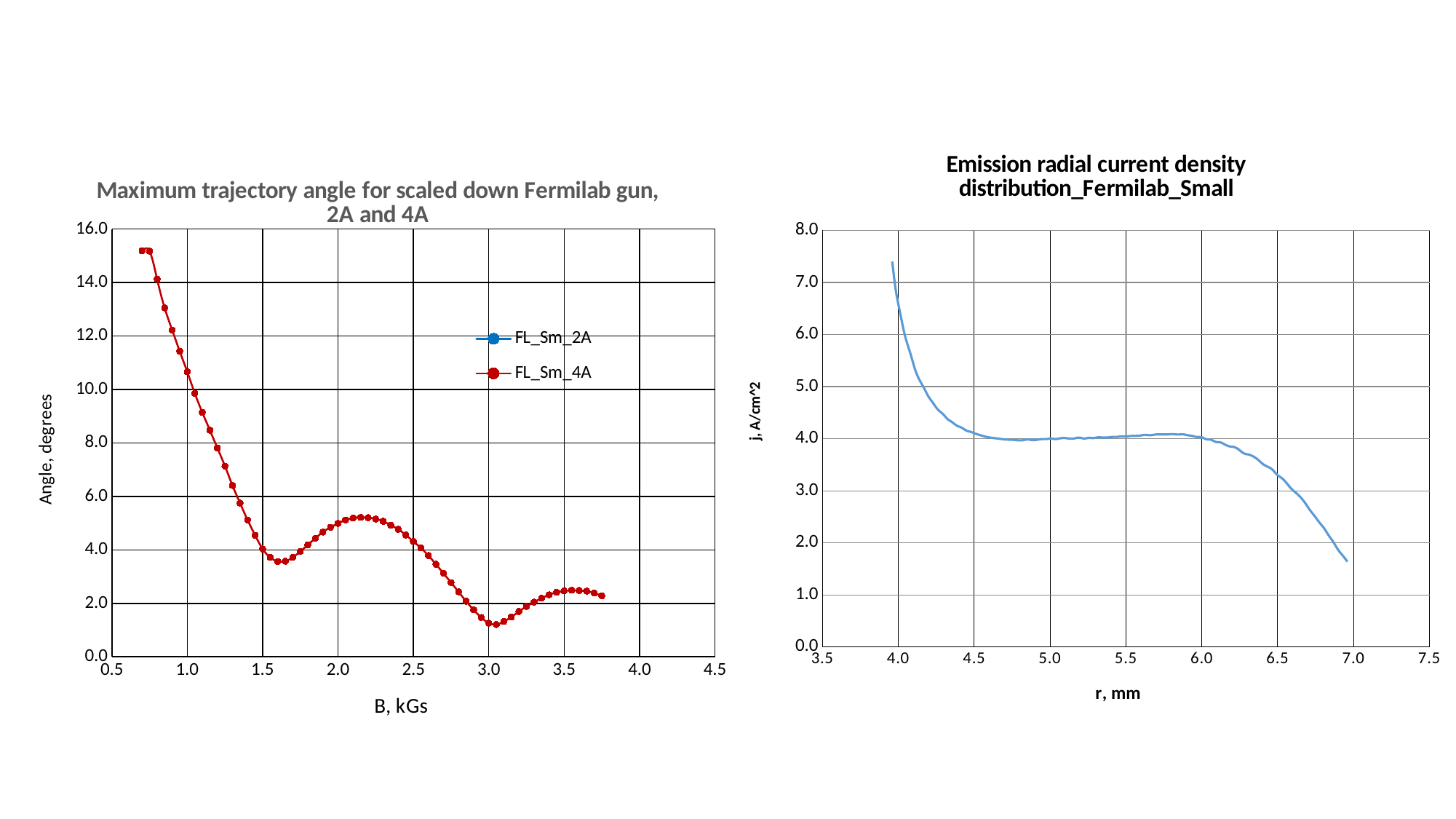
What kind of chart is the 'Emission radial current density distribution_Fermilab_Small' chart? line chart What is the x-axis title of the 'Maximum trajectory angle' chart? B, kGs How many series does the legend of the 'Maximum trajectory angle' chart list? 2 In the 'Maximum trajectory angle' chart, is the angle at B = 3.0 kGs greater or less than 2.0 degrees? less What are the series names in the legend of the 'Maximum trajectory angle' chart? FL_Sm_2A and FL_Sm_4A In the 'Emission radial current density distribution_Fermilab_Small' chart, does the current density rise or fall between r = 4.0 mm and r = 4.5 mm? fall In the 'Maximum trajectory angle' chart, is the angle at B = 0.75 kGs greater or less than 14.0 degrees? greater In the 'Maximum trajectory angle' chart, is the angle at B = 1.25 kGs greater or less than 6.0 degrees? greater What kind of chart is the 'Maximum trajectory angle for scaled down Fermilab gun, 2A and 4A' chart? line chart